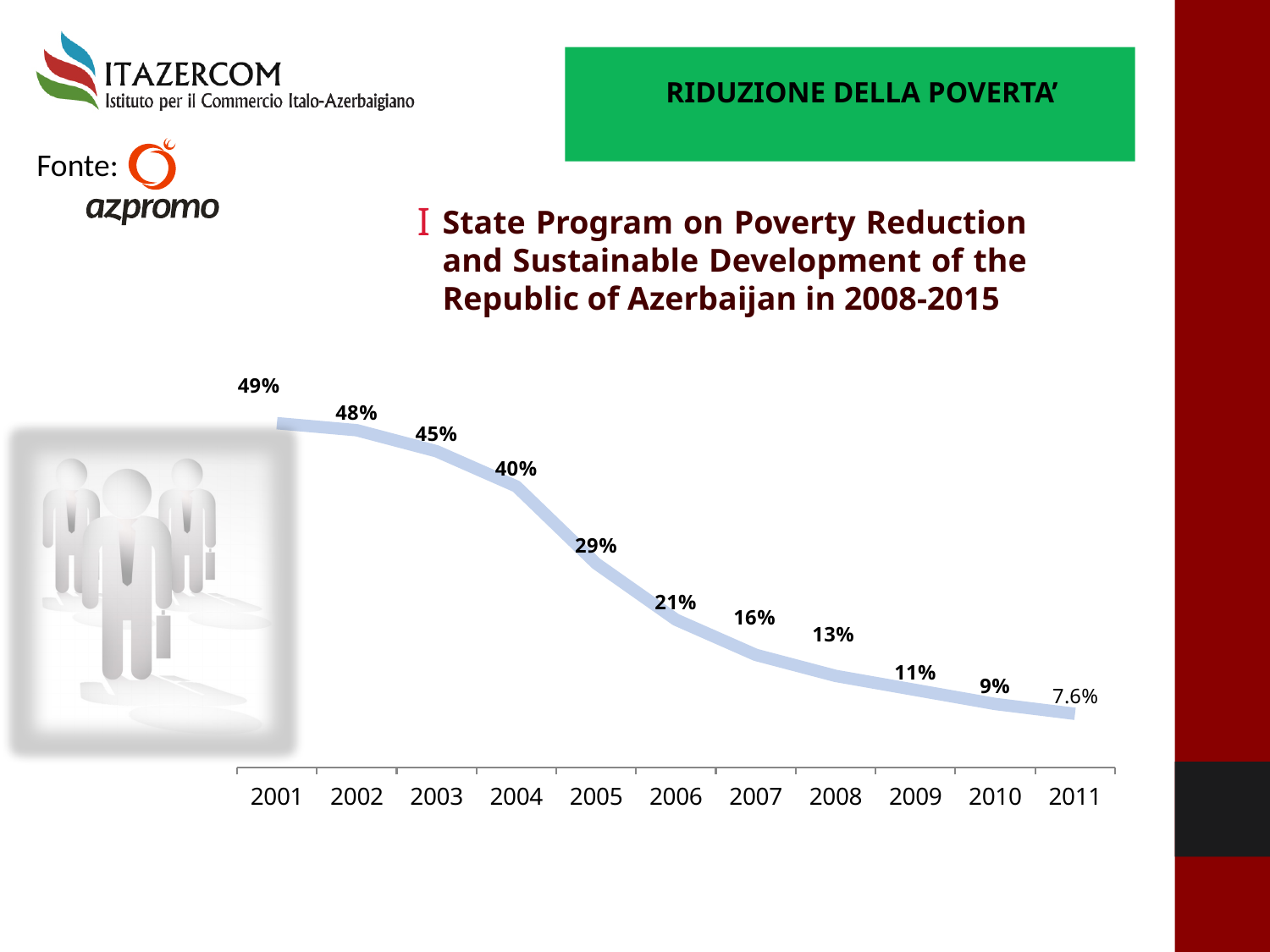
Which year has the lowest value? 2011 What is the value for 2008? 13% What is the difference between the values for 2001 and 2011? 41.4% Do the values rise or fall from 2001 to 2011? fall What is the difference between the values for 2004 and 2005? 11% What kind of chart is this? line chart What is the value for 2011? 7.6% How many years are shown on the x axis? 11 What is the value for 2005? 29% Which year has the highest value? 2001 Which is larger, the value for 2006 or the value for 2007? 2006 What is the value for 2001? 49%